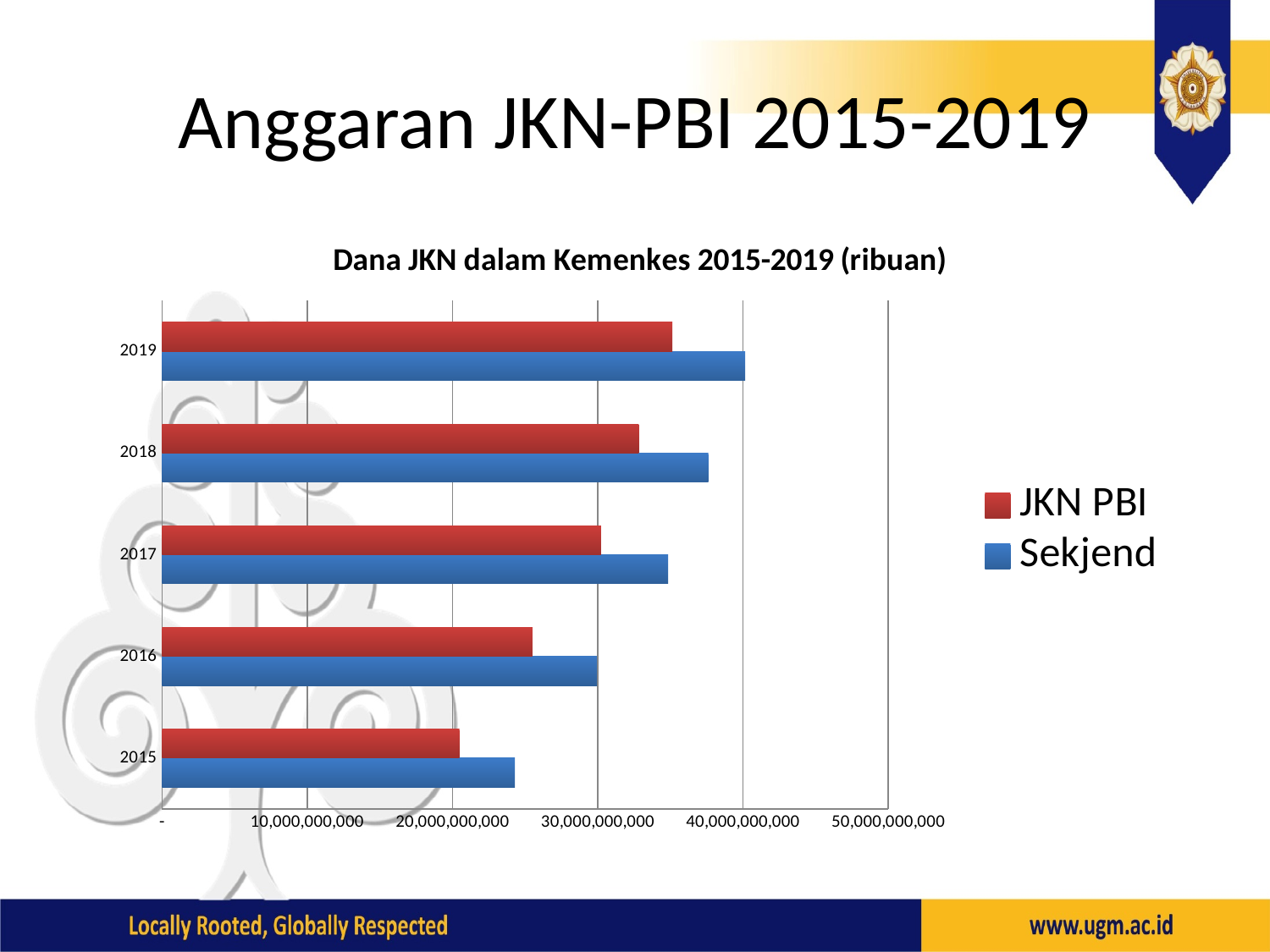
How many series does the legend list? 2 Is the Sekjend value for 2015 greater or less than 30,000,000,000? less Is the JKN PBI value for 2016 greater or less than 20,000,000,000? greater Which year has the highest Sekjend value? 2019 Which series is shown in red? JKN PBI Which is larger in 2018, the JKN PBI value or the Sekjend value? Sekjend What type of chart is shown on the slide? bar chart What is the title of the chart? Dana JKN dalam Kemenkes 2015-2019 (ribuan) Which year has the lowest JKN PBI value? 2015 Do the JKN PBI values rise or fall from 2015 to 2019? rise How many years are shown on the chart? 5 Is the JKN PBI value for 2019 greater or less than 30,000,000,000? greater